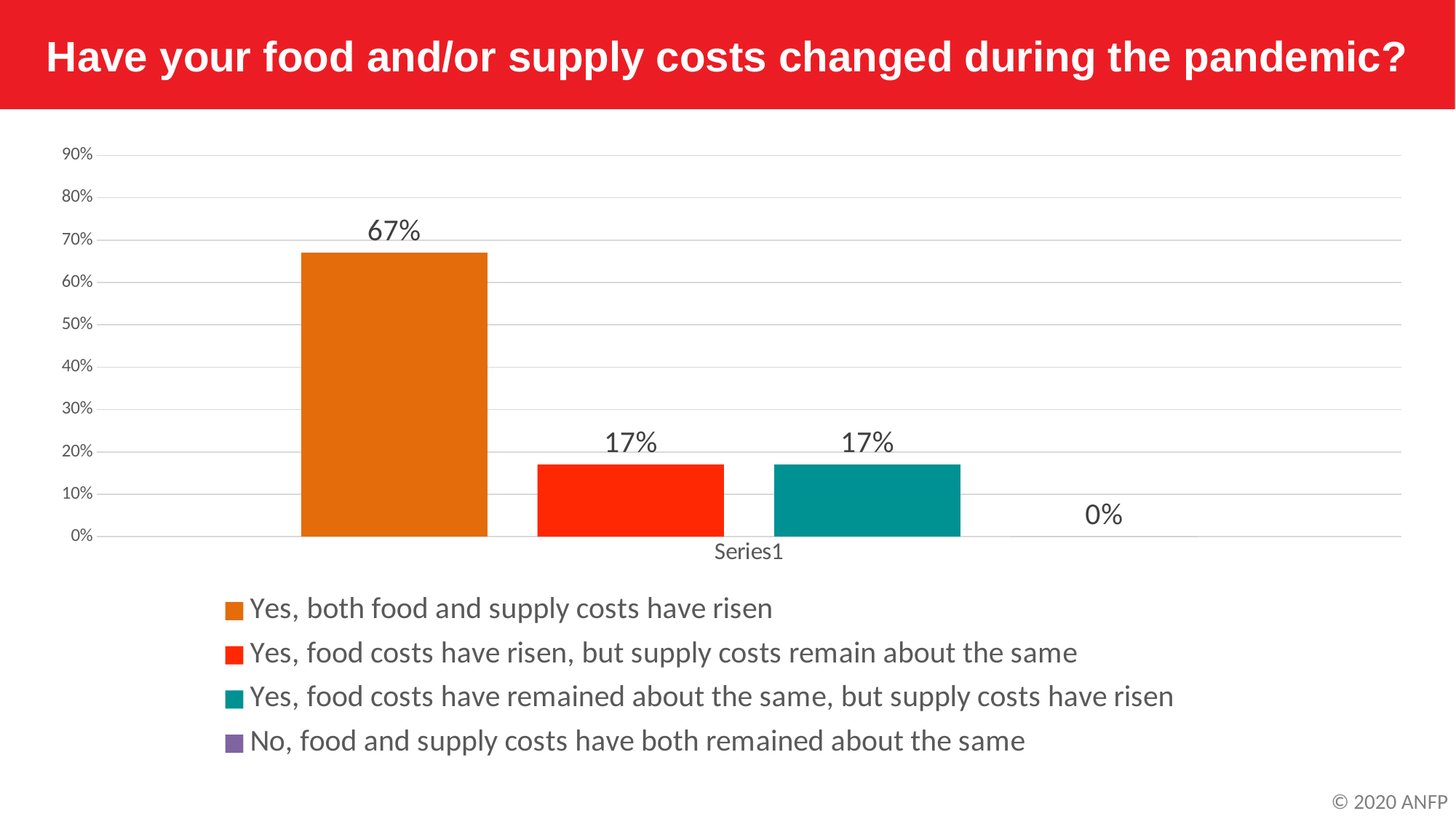
What percentage of respondents said both food and supply costs have risen? 67% Which response has the highest percentage? Yes, both food and supply costs have risen What kind of chart is shown on the slide? Bar chart What percentage of respondents said food costs have risen but supply costs remain about the same? 17% Which is larger: the value for 'Yes, both food and supply costs have risen' or the value for 'Yes, food costs have remained about the same, but supply costs have risen'? Yes, both food and supply costs have risen What percentage of respondents said food and supply costs have both remained about the same? 0% What is the difference in percentage points between 'Yes, both food and supply costs have risen' and 'Yes, food costs have risen, but supply costs remain about the same'? 50 percentage points Is the value for 'Yes, both food and supply costs have risen' greater or less than 60%? greater What colour is the bar for 'Yes, food costs have remained about the same, but supply costs have risen'? Teal Which response has the lowest percentage? No, food and supply costs have both remained about the same How many response options does the legend list? 4 What percentage of respondents said food costs have remained about the same but supply costs have risen? 17%